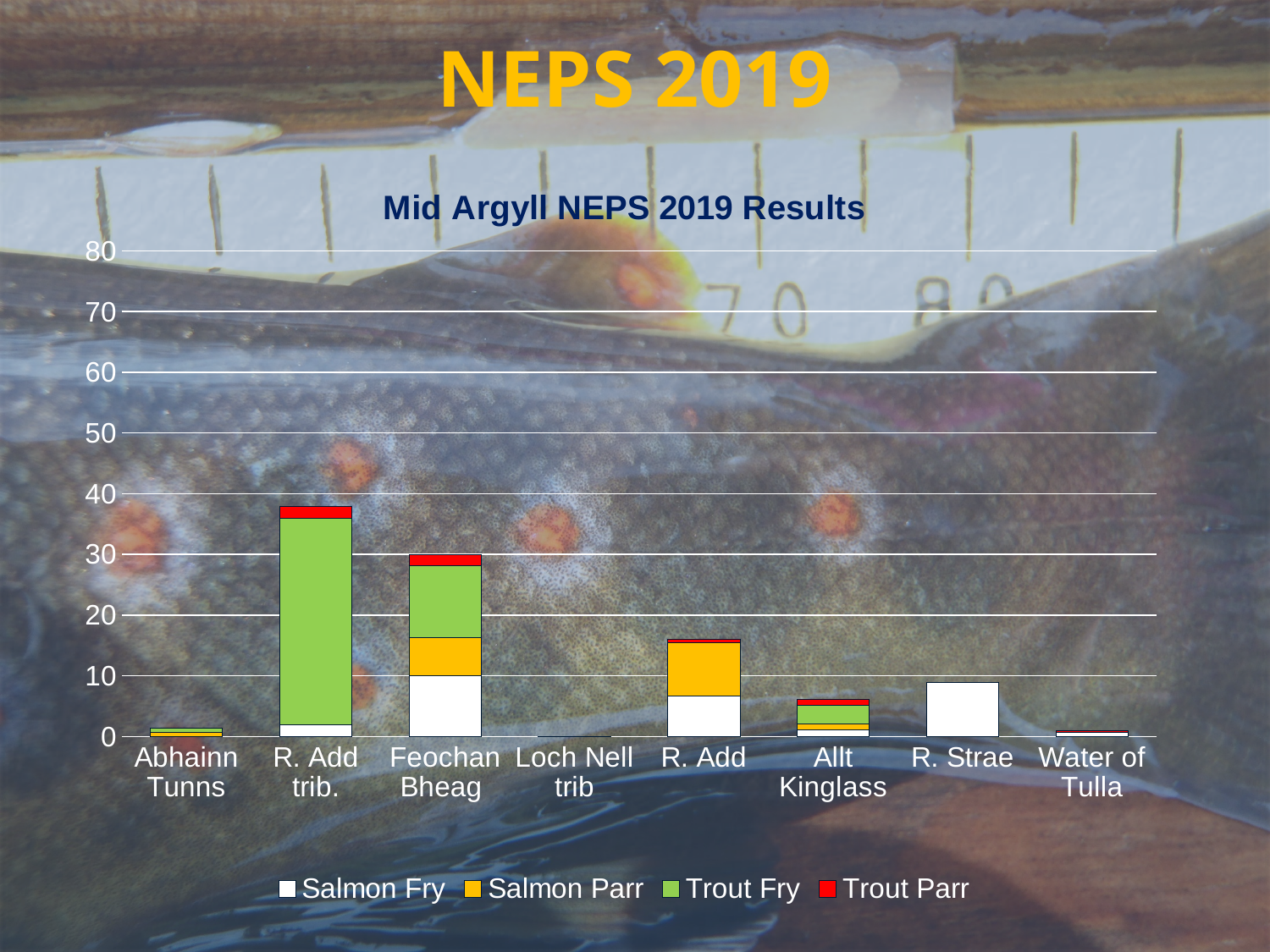
How many series does the legend list? 4 Is the total for Feochan Bheag greater or less than 20? greater What is the title of the chart? Mid Argyll NEPS 2019 Results How many categories are shown on the x axis? 8 Is the total for R. Add greater or less than 10? greater Which has the larger total, R. Strae or Water of Tulla? R. Strae Is the total for Allt Kinglass greater or less than 10? less Which has the larger total, R. Add trib. or Feochan Bheag? R. Add trib. Which colour represents Trout Fry in the legend? Green What type of chart is shown on the slide? Stacked bar chart Which category has the tallest stacked bar? R. Add trib.